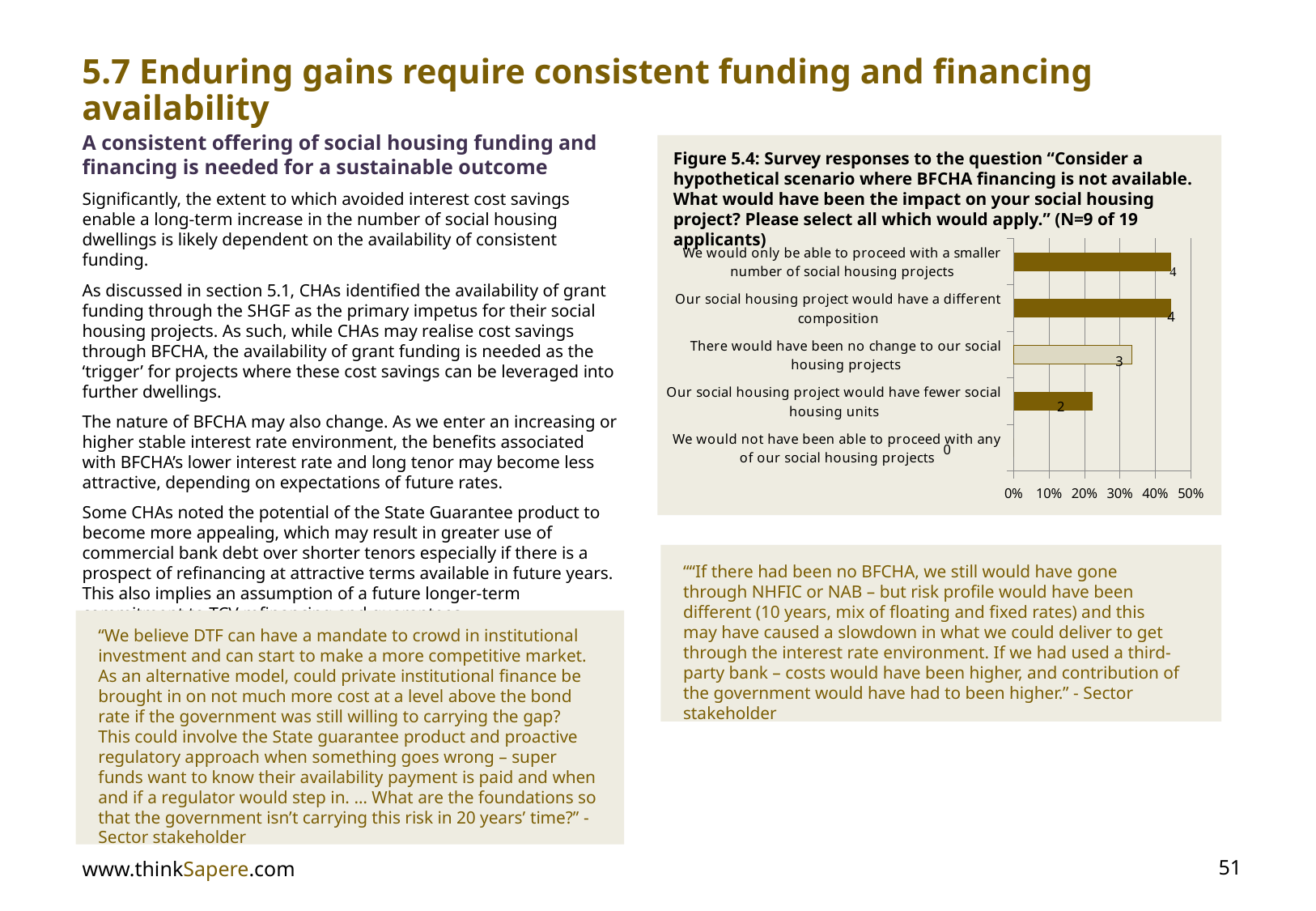
What kind of chart is shown in Figure 5.4? bar chart In Figure 5.4, what is the difference between the data labels for "There would have been no change to our social housing projects" and "Our social housing project would have fewer social housing units"? 1 In Figure 5.4, which response has the lowest value? We would not have been able to proceed with any of our social housing projects In Figure 5.4, what is the data label for "We would only be able to proceed with a smaller number of social housing projects"? 4 In Figure 5.4, what is the data label for "We would not have been able to proceed with any of our social housing projects"? 0 In Figure 5.4, is the bar for "Our social housing project would have fewer social housing units" greater or less than 30%? less How many response categories are plotted in Figure 5.4? 5 In Figure 5.4, which is larger: the value for "Our social housing project would have a different composition" or the value for "Our social housing project would have fewer social housing units"? Our social housing project would have a different composition In Figure 5.4, is the bar for "We would only be able to proceed with a smaller number of social housing projects" greater or less than 40%? greater In Figure 5.4, what is the data label for "Our social housing project would have fewer social housing units"? 2 What is the maximum value shown on the horizontal axis of Figure 5.4? 50% In Figure 5.4, what is the data label for "There would have been no change to our social housing projects"? 3